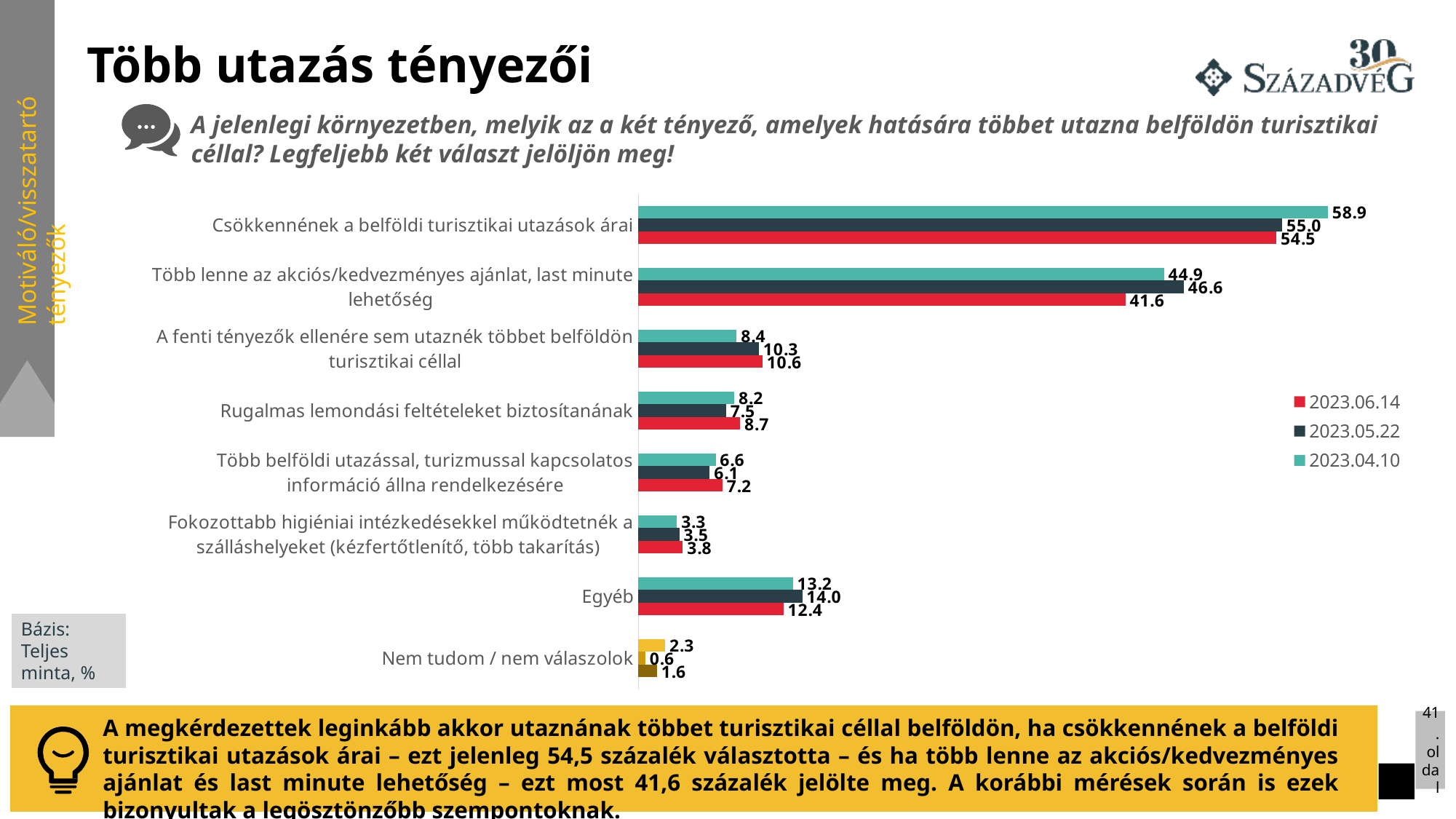
How many series does the legend list? 3 What is the 2023.06.14 value for 'Fokozottabb higiéniai intézkedésekkel működtetnék a szálláshelyeket (kézfertőtlenítő, több takarítás)'? 3.8 For 'Rugalmas lemondási feltételeket biztosítanának', which is larger: the 2023.06.14 value or the 2023.05.22 value? 2023.06.14 Which category has the lowest value in the 2023.05.22 series? Nem tudom / nem válaszolok Which series is shown in red in the legend? 2023.06.14 Which category has the highest value in the 2023.06.14 series? Csökkennének a belföldi turisztikai utazások árai What is the 2023.05.22 value for 'Egyéb'? 14.0 What is the 2023.04.10 value for 'Több lenne az akciós/kedvezményes ajánlat, last minute lehetőség'? 44.9 How many categories are shown on the chart? 8 What is the difference between the 2023.04.10 and 2023.06.14 values for 'Csökkennének a belföldi turisztikai utazások árai'? 4.4 What type of chart is shown on the slide? bar chart What is the 2023.06.14 value for 'Csökkennének a belföldi turisztikai utazások árai'? 54.5